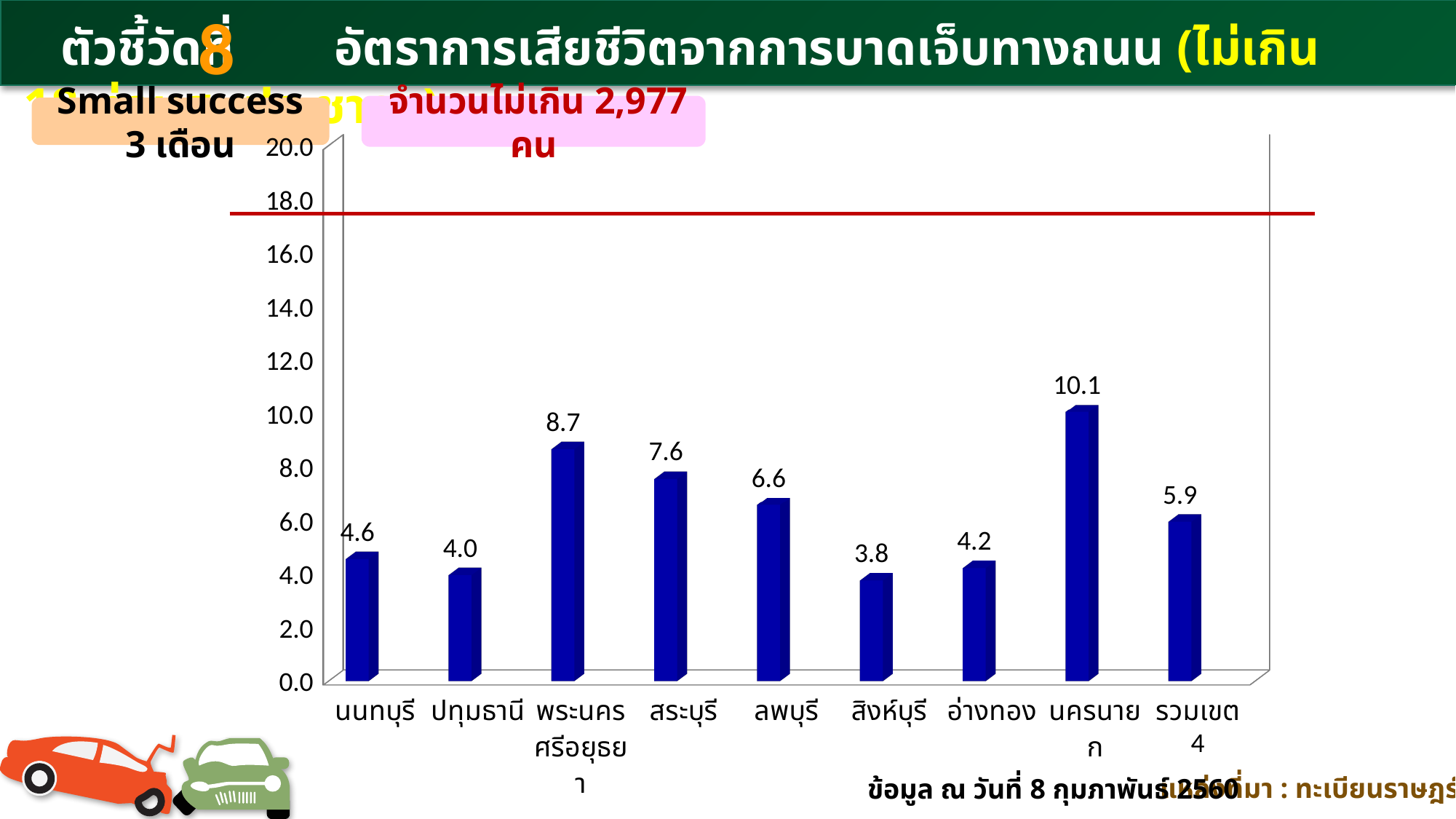
What is the difference between the values for พระนครศรีอยุธยา and สระบุรี? 1.1 Which province has the highest value? นครนายก What is the value for นครนายก? 10.1 What is the highest value shown on the y axis? 20.0 What is the difference between the values for นครนายก and สิงห์บุรี? 6.3 Which is larger, the value for ลพบุรี or the value for อ่างทอง? ลพบุรี Which province has the lowest value? สิงห์บุรี Is the value for นครนายก greater or less than 8.0? greater What is the value for นนทบุรี? 4.6 What is the value for รวมเขต 4? 5.9 How many categories are shown on the x axis? 9 What kind of chart is shown on the slide? bar chart